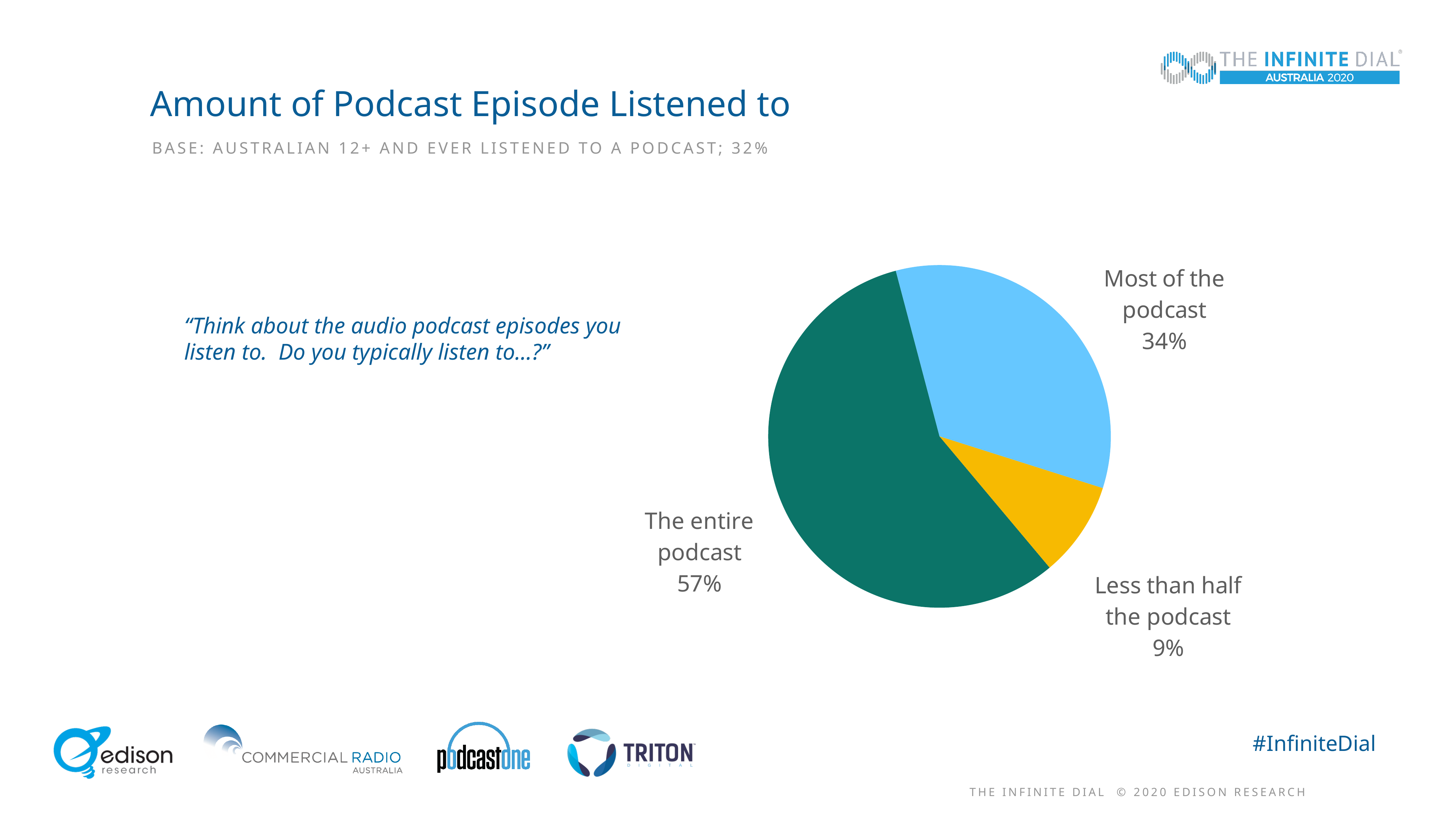
Which category has the smallest share of the pie? Less than half the podcast Which category has the largest share of the pie? The entire podcast What is the title of the chart on the slide? Amount of Podcast Episode Listened to What is the difference in percentage points between 'Most of the podcast' and 'Less than half the podcast'? 25 What percentage typically listen to most of the podcast? 34% Which is larger: the share for 'Most of the podcast' or 'Less than half the podcast'? Most of the podcast What kind of chart is shown on the slide? Pie chart What percentage of podcast listeners typically listen to the entire podcast? 57% What colour is the slice for 'Less than half the podcast'? Yellow What percentage typically listen to less than half the podcast? 9% How many slices does the pie chart have? 3 What is the difference in percentage points between 'The entire podcast' and 'Most of the podcast'? 23